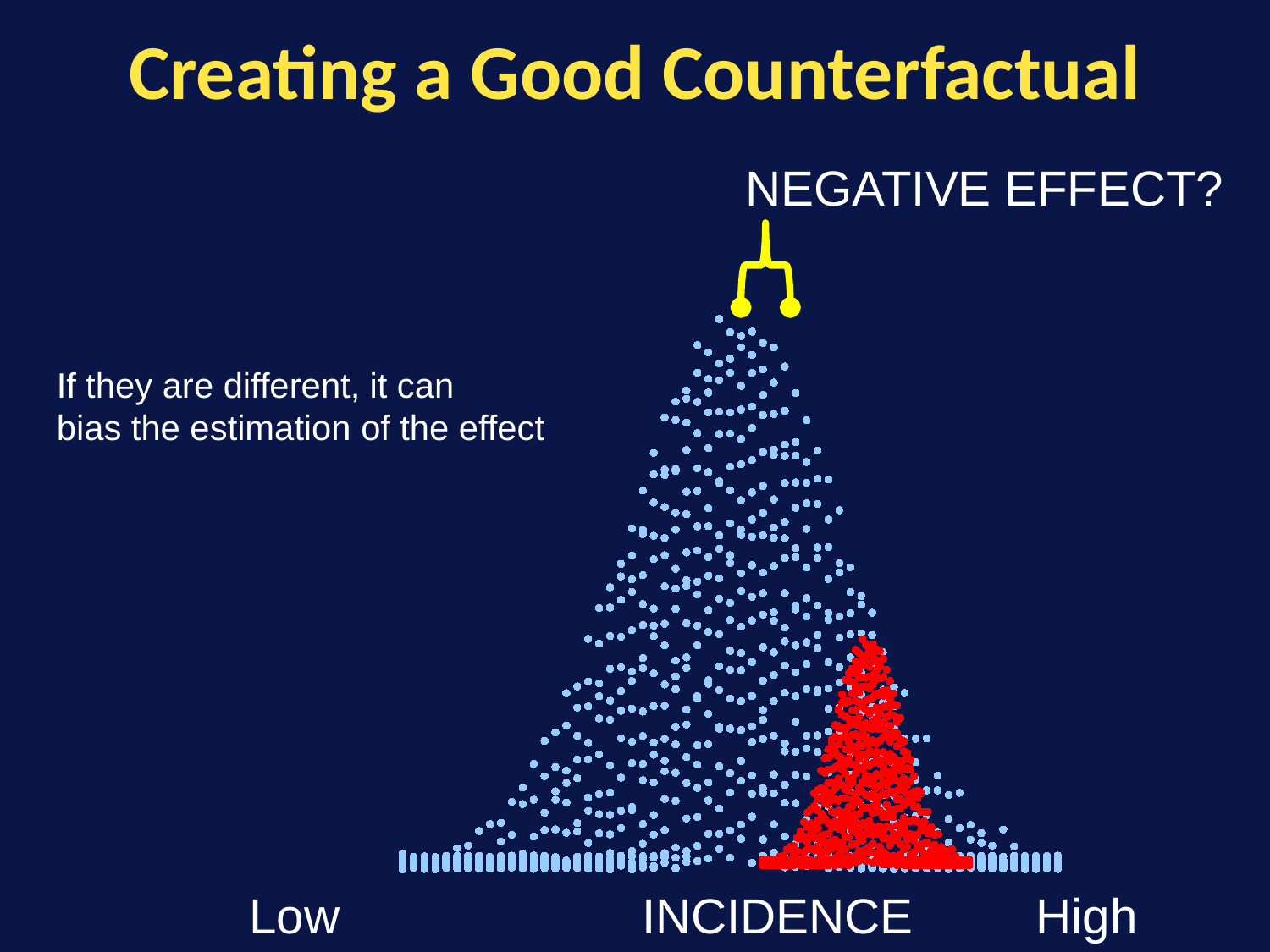
Is the red group of dots located toward the Low end or the High end of the incidence axis? High end How many differently coloured groups of dots are plotted in the chart? 2 Which group of dots spans a wider range of incidence, the red group or the blue group? The blue group Which group of dots reaches the greater height at its peak, the red group or the blue group? The blue group What is the label of the horizontal axis of the chart? INCIDENCE What are the two end labels of the horizontal axis, from left to right? Low and High What kind of chart is shown on the slide? Dot plot